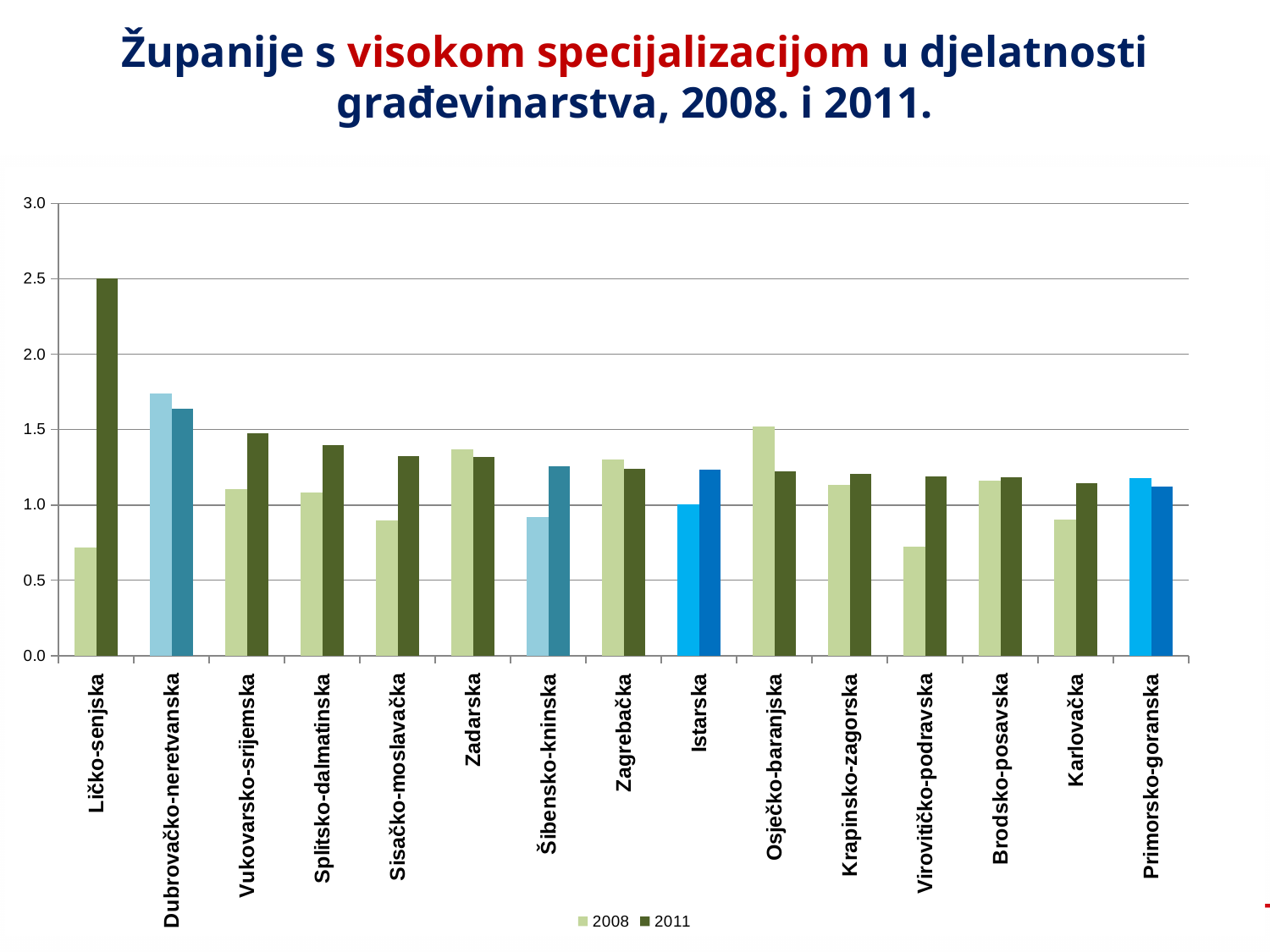
Which county has the highest value for 2008? Dubrovačko-neretvanska How many counties (categories) are shown on the x axis? 15 What kind of chart is shown on the slide? bar chart What are the two entries listed in the legend? 2008 and 2011 Is the 2008 value for Sisačko-moslavačka greater or less than 1.0? less Is the 2008 value for Dubrovačko-neretvanska greater or less than 1.5? greater Is the 2011 value for Ličko-senjska greater or less than 2.0? greater For Ličko-senjska, which is larger: the 2008 value or the 2011 value? 2011 For Osječko-baranjska, which is larger: the 2008 value or the 2011 value? 2008 How many series does the legend list? 2 Which county has the highest value for 2011? Ličko-senjska For Dubrovačko-neretvanska, which is larger: the 2008 value or the 2011 value? 2008